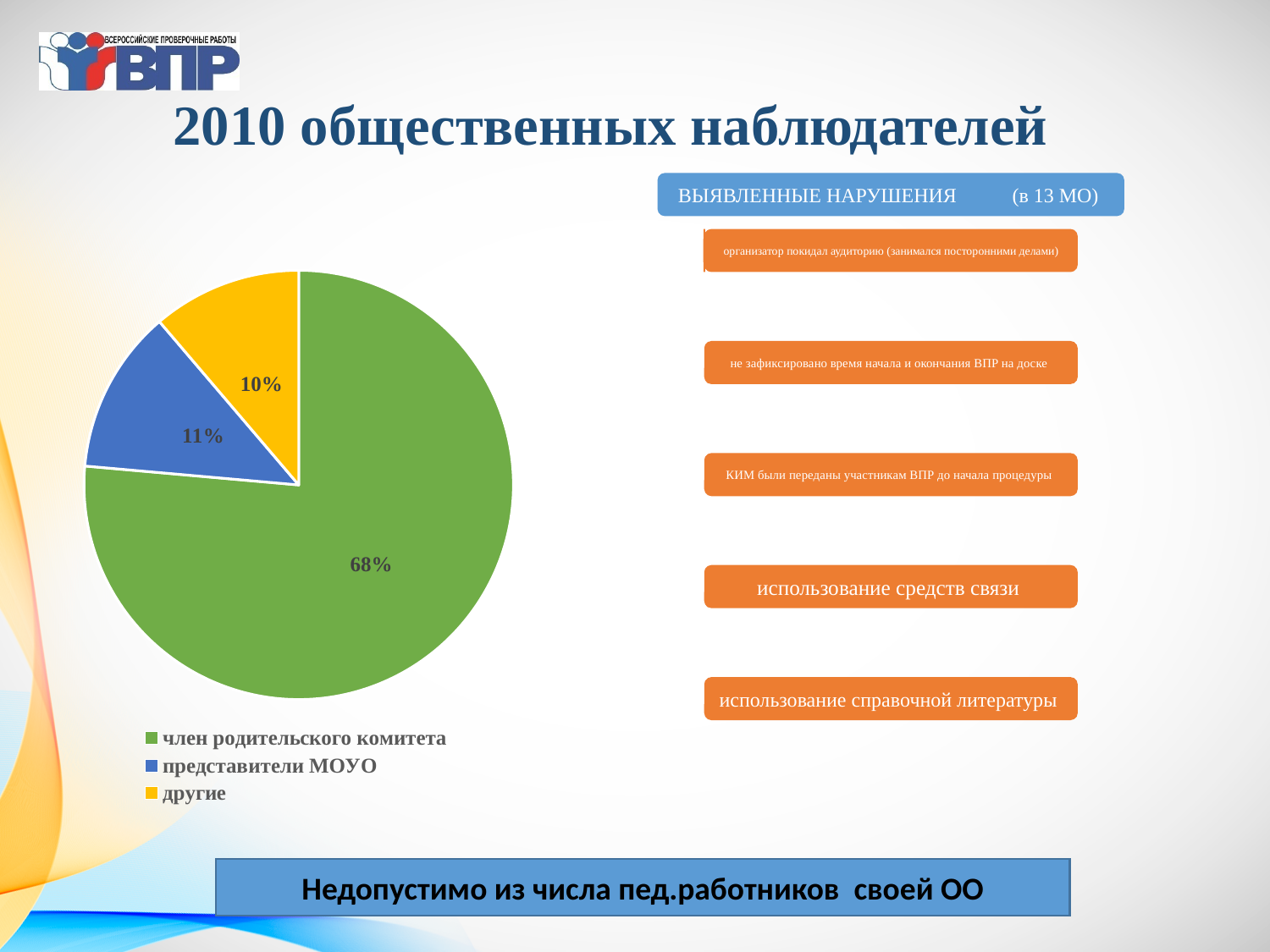
What is the difference in percentage points between the slices for "член родительского комитета" and "представители МОУО"? 57 Which category has the smallest slice of the pie? другие Which category has the largest slice of the pie? член родительского комитета What share of the pie is labelled for "другие"? 10% What share of the pie is labelled for "представители МОУО"? 11% What colour is the slice for "член родительского комитета"? green Which is larger: the slice for "представители МОУО" or the slice for "другие"? представители МОУО What share of the pie is labelled for "член родительского комитета"? 68% How many entries does the legend of the pie chart list? 3 What kind of chart is shown on the slide? pie chart How many categories does the pie chart show? 3 What colour is the slice for "другие"? yellow